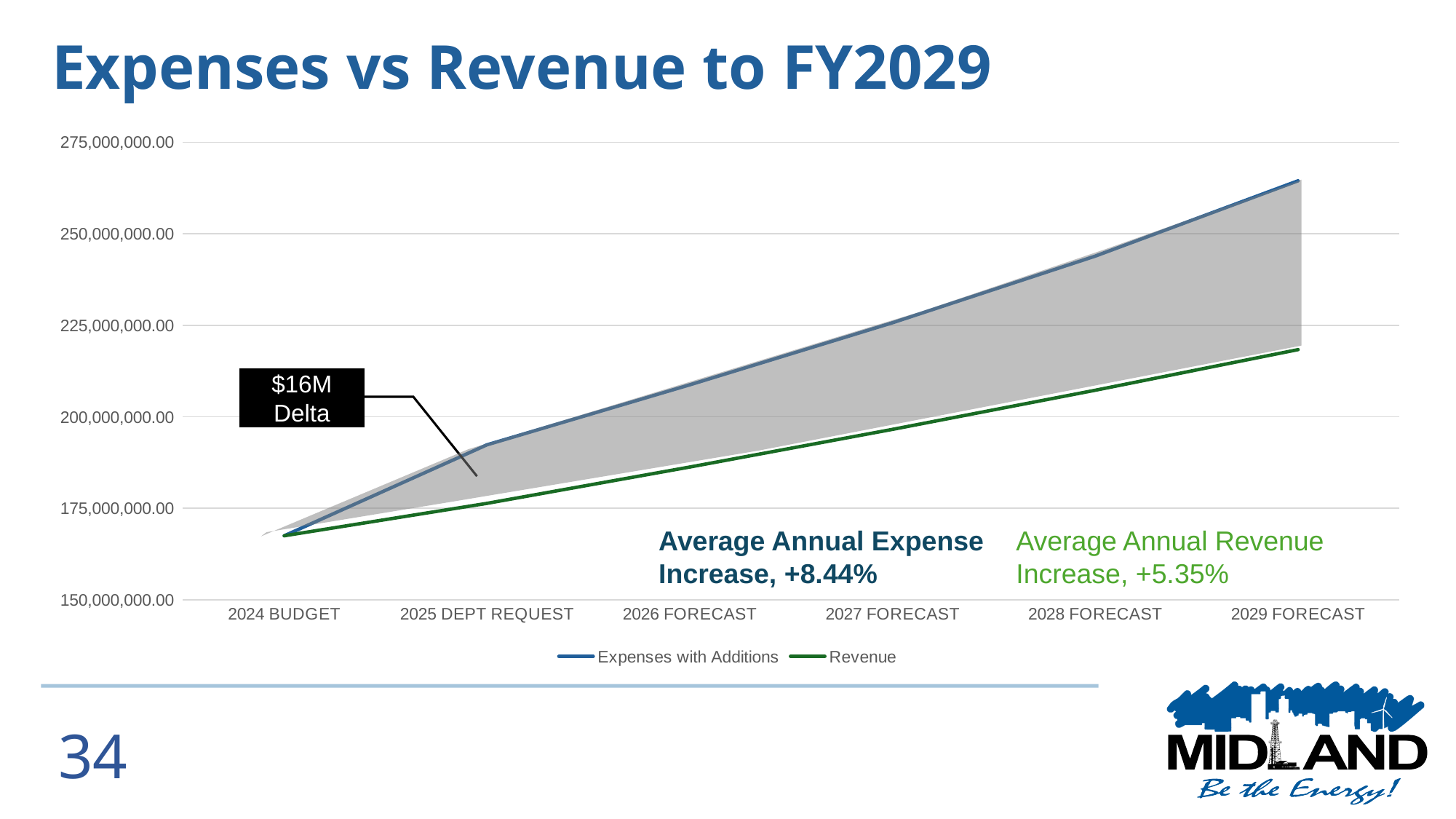
What kind of chart is shown on the slide? line chart How many categories are shown along the x axis? 6 Is the Revenue value for 2024 BUDGET greater or less than 175,000,000.00? less At which category is the Revenue series lowest? 2024 BUDGET Is the Expenses with Additions value for 2029 FORECAST greater or less than 250,000,000.00? greater Is the Revenue value for 2029 FORECAST greater or less than 225,000,000.00? less At which category is the Expenses with Additions series highest? 2029 FORECAST What is the average annual expense increase stated on the chart? +8.44% What delta does the callout box on the chart indicate? $16M Delta Do the Expenses with Additions values rise or fall from 2024 BUDGET to 2029 FORECAST? rise At 2029 FORECAST, which is larger: Expenses with Additions or Revenue? Expenses with Additions How many series does the legend list? 2